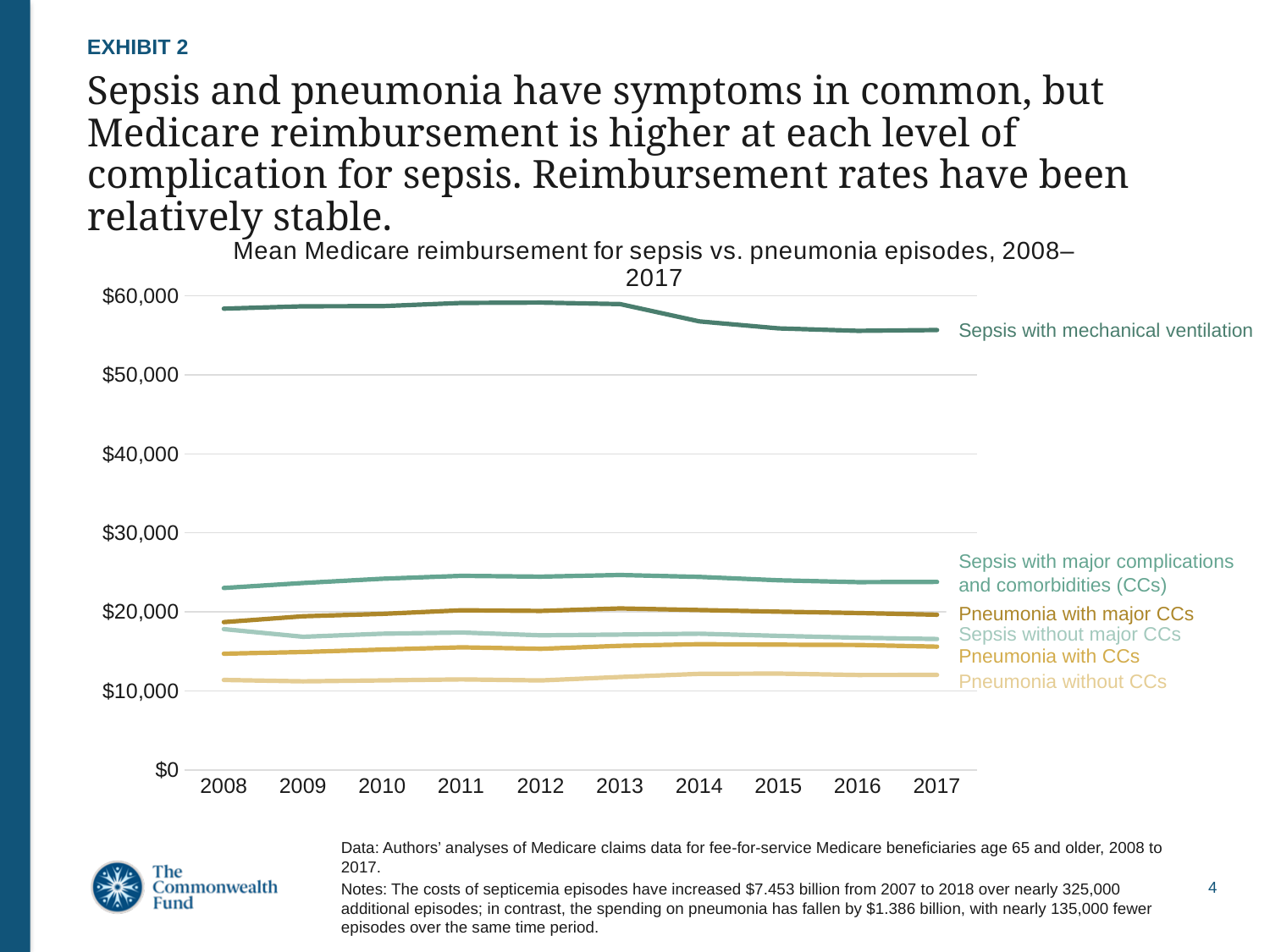
In 2008, which is higher: Sepsis without major CCs or Pneumonia with CCs? Sepsis without major CCs In 2017, which is higher: Sepsis with major CCs or Pneumonia with major CCs? Sepsis with major CCs Which series has the lowest reimbursement across the chart? Pneumonia without CCs What is the title of the chart? Mean Medicare reimbursement for sepsis vs. pneumonia episodes, 2008–2017 What kind of chart is shown on the slide? Line chart Is the value for Sepsis with mechanical ventilation in 2008 greater or less than $50,000? greater Which series has the highest reimbursement across the chart? Sepsis with mechanical ventilation Does the Sepsis with mechanical ventilation line rise or fall from 2013 to 2017? Fall Is the value for Pneumonia without CCs in 2008 greater or less than $20,000? less How many years are shown along the x axis of the chart? 10 How many series (lines) are labeled on the chart? 6 Is the value for Sepsis with major complications and comorbidities (CCs) in 2017 greater or less than $20,000? greater